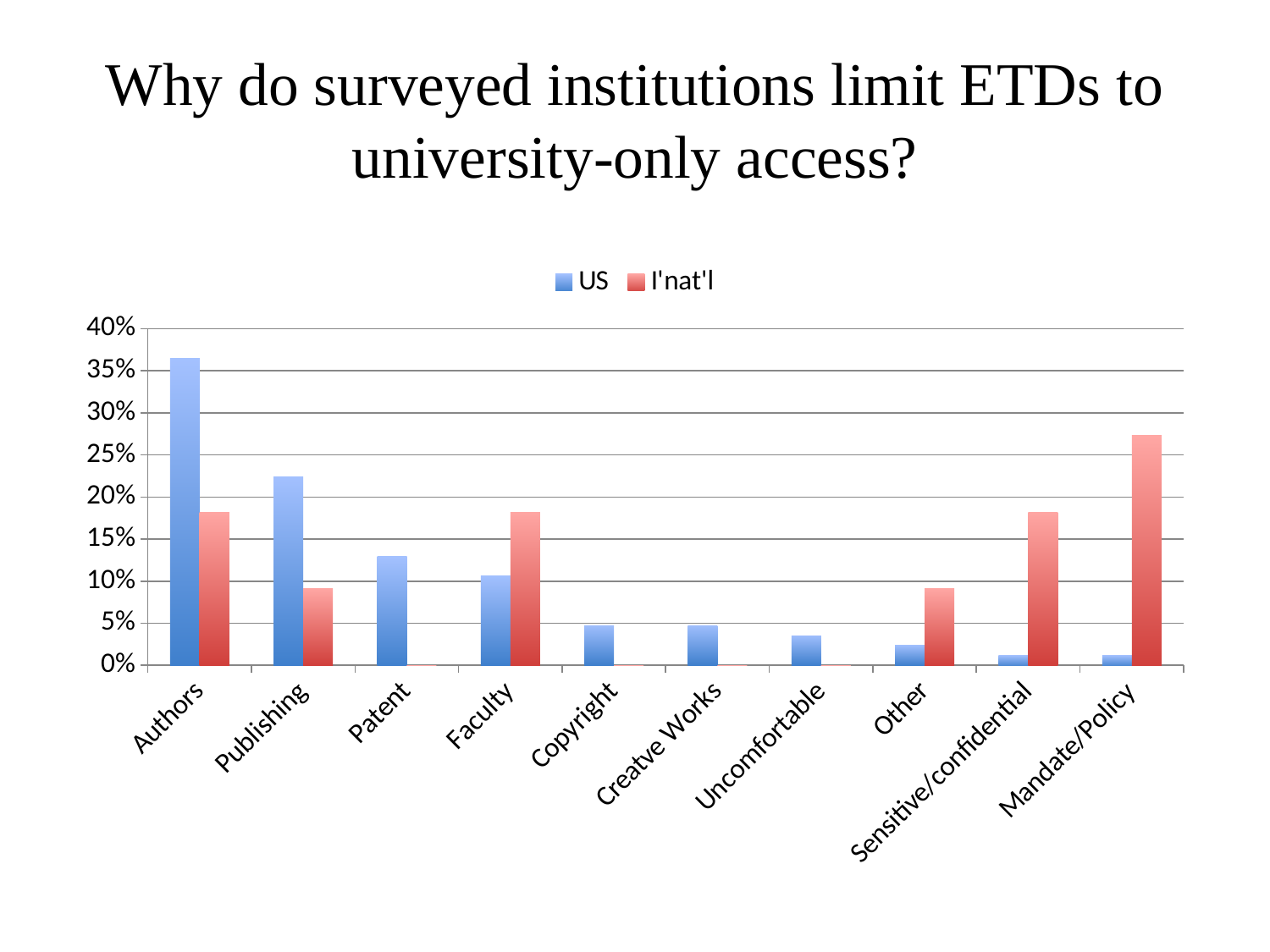
Is the US value for Authors greater or less than 30%? greater Which category has the highest value for the US series? Authors How many series does the legend list? 2 Is the I'nat'l value for Mandate/Policy greater or less than 25%? greater What kind of chart is shown on the slide? bar chart Is the US value for Patent greater or less than 10%? greater Which colour represents the I'nat'l series in the legend? red How many categories are shown on the x axis? 10 For Publishing, which series has the larger value, US or I'nat'l? US Which category has the highest value for the I'nat'l series? Mandate/Policy For Faculty, which series has the larger value, US or I'nat'l? I'nat'l